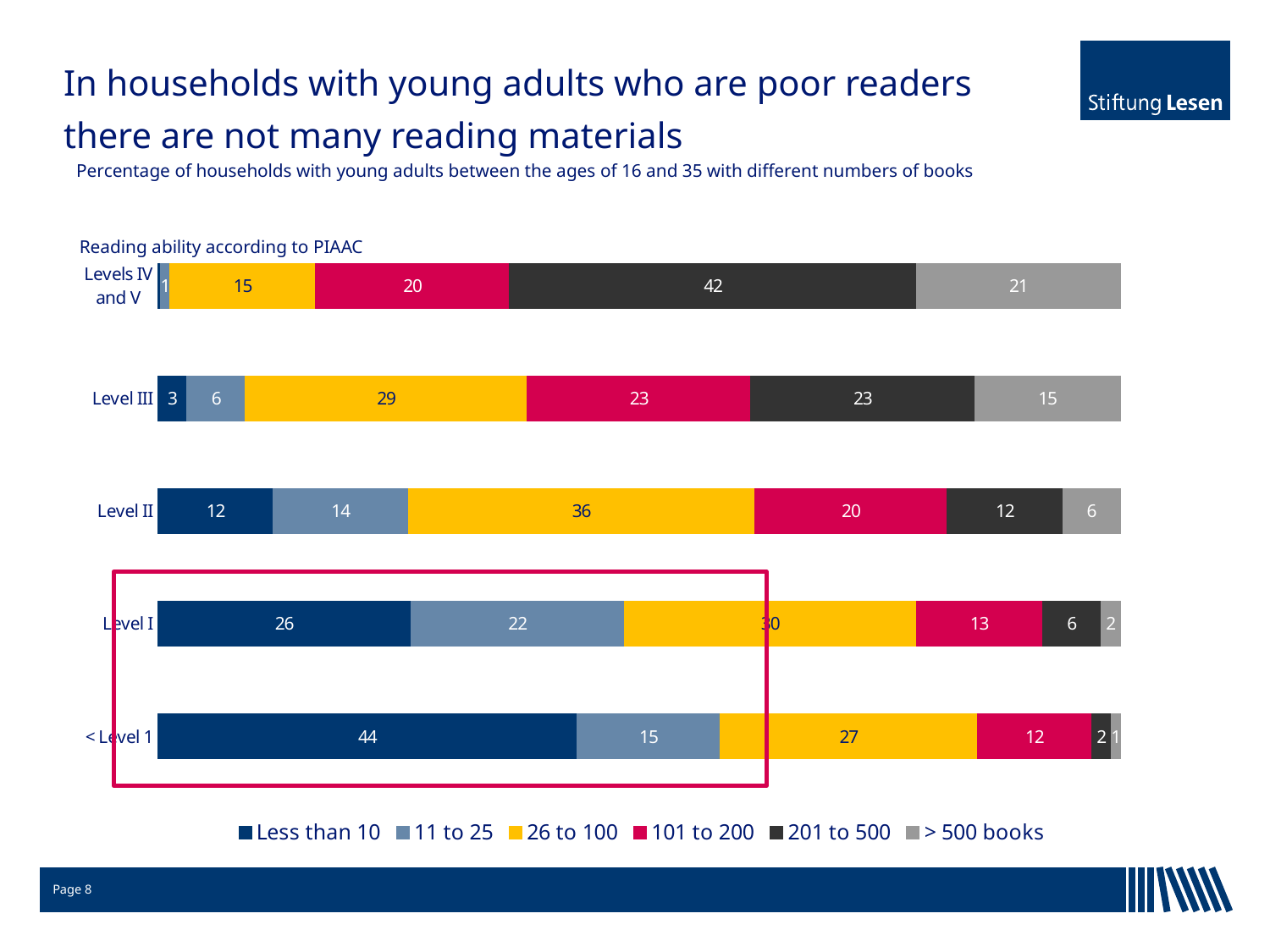
Which reading level has the highest value for 'Less than 10' books? < Level 1 What kind of chart is shown on the slide? Stacked bar chart What is the total of the Level II stacked bar? 100 What is the value for 'Less than 10' books in the '< Level 1' bar? 44 What is the difference between the 'Less than 10' values for Level I and Level II? 14 What is the value for '201 to 500' books for Levels IV and V? 42 How many reading level categories are shown in the chart? 5 What percentage of Level II households have 26 to 100 books? 36 Which reading level has the lowest value for '> 500 books'? < Level 1 What is the value for '101 to 200' books in the Level III bar? 23 Which has a larger value for '26 to 100' books, Level III or Level II? Level II How many series does the legend list? 6